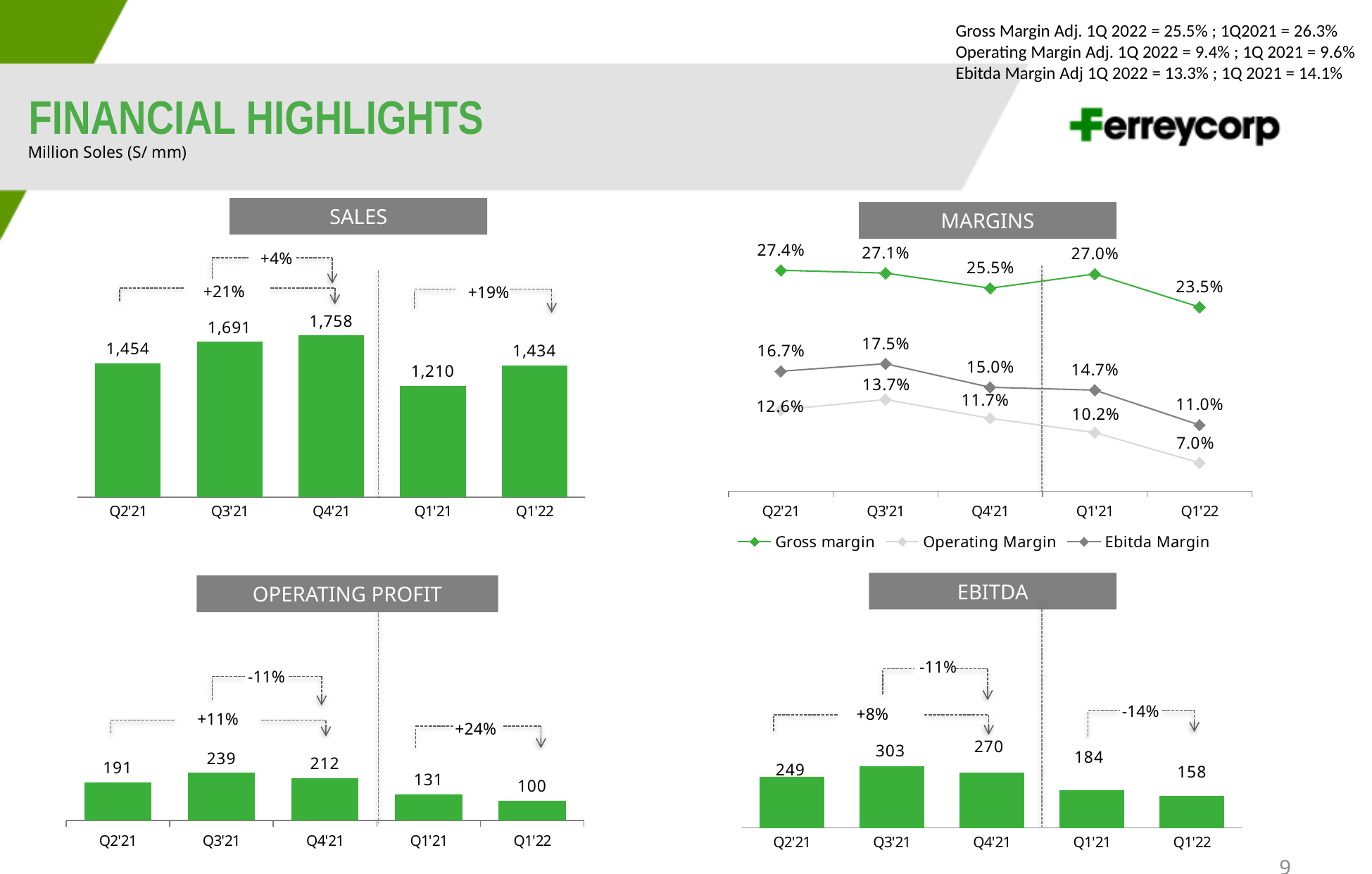
In the OPERATING PROFIT chart, what is the value for Q1'22? 100 In the MARGINS chart, does the Ebitda Margin rise or fall from Q3'21 to Q1'22? fall How many quarters are shown in the EBITDA chart? 5 What kind of chart is the MARGINS chart? line chart In the SALES chart, what is the value for Q4'21? 1,758 How many series does the legend of the MARGINS chart list? 3 In the SALES chart, what is the difference between Q1'22 and Q1'21? 224 In the EBITDA chart, which is larger, Q2'21 or Q4'21? Q4'21 In the MARGINS chart, what is the Gross margin for Q1'22? 23.5% In the OPERATING PROFIT chart, which quarter has the highest value? Q3'21 In the SALES chart, which quarter has the lowest sales? Q1'21 In the MARGINS chart, what is the Operating Margin for Q3'21? 13.7%